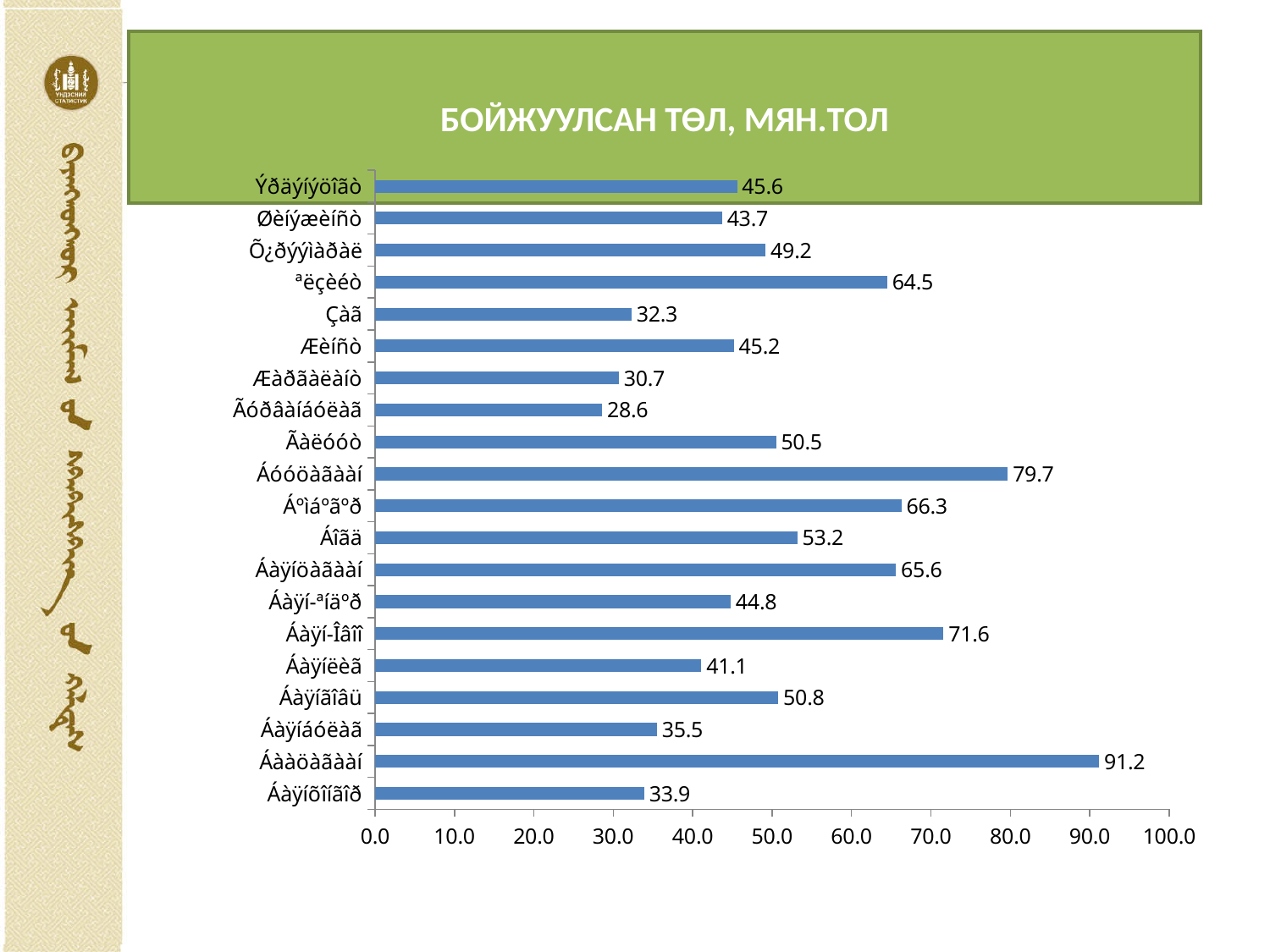
What is the value of the bottom bar in the chart? 33.9 Which is larger: the value of the tenth bar from the top (79.7) or the fifteenth bar from the top (71.6)? the tenth bar from the top (79.7) What is the highest value shown in the chart? 91.2 How many bars (categories) are plotted in the chart? 20 What is the maximum value shown on the horizontal axis? 100.0 What is the value of the fourth bar from the top? 64.5 Is the value of the bottom bar greater or less than 40.0? less What is the lowest value shown in the chart? 28.6 What is the title of the chart? БОЙЖУУЛСАН ТӨЛ, МЯН.ТОЛ What is the difference between the highest value (91.2) and the second highest value (79.7)? 11.5 What is the value of the topmost bar in the chart? 45.6 What type of chart is shown on the slide? bar chart